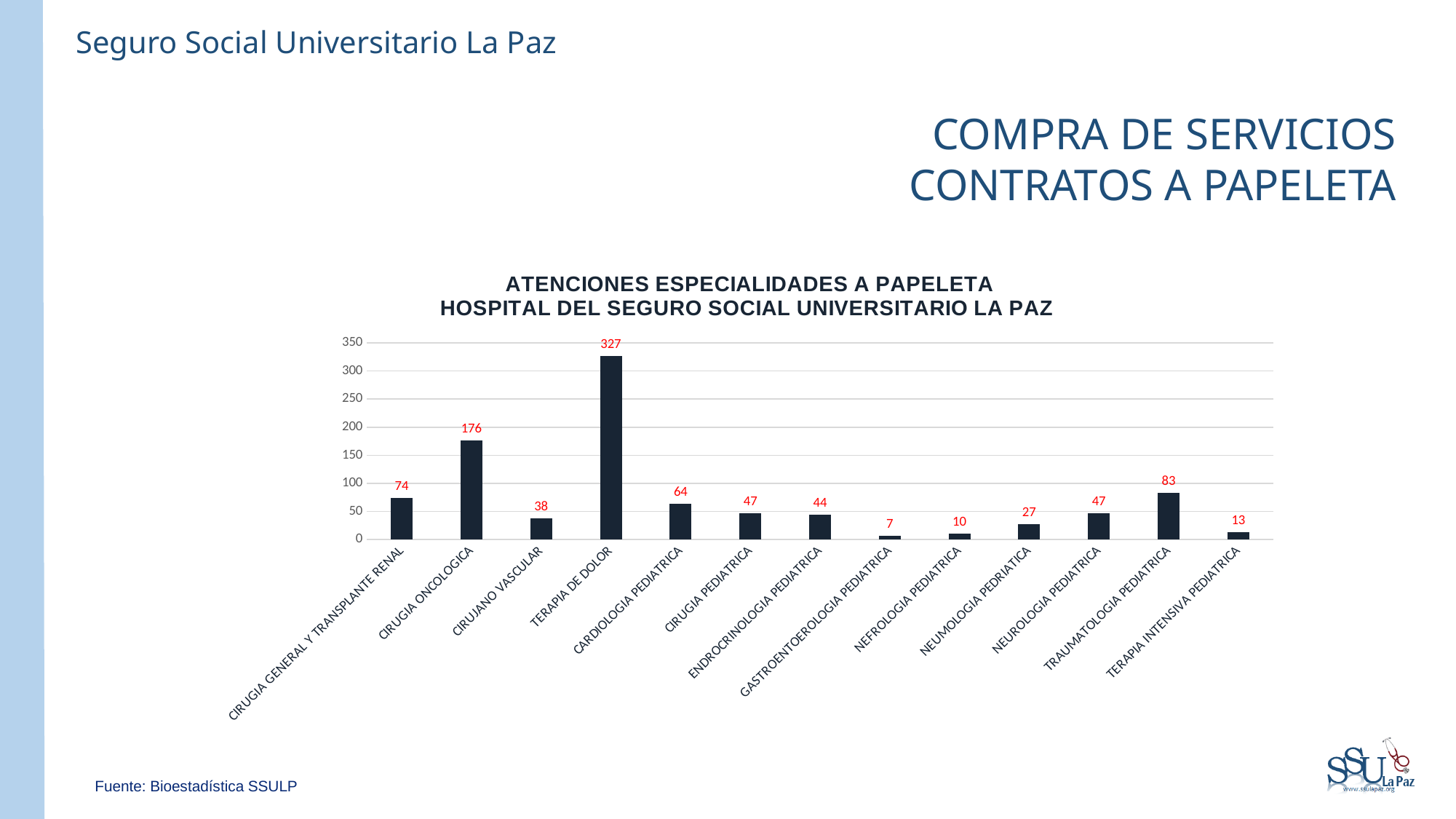
What is the value for TERAPIA DE DOLOR? 327 How many categories are shown on the x axis? 13 What kind of chart is shown on the slide? bar chart Which category has the lowest value? GASTROENTOEROLOGIA PEDIATRICA Which is larger, the value for CARDIOLOGIA PEDIATRICA or the value for CIRUJANO VASCULAR? CARDIOLOGIA PEDIATRICA Which category has the highest value? TERAPIA DE DOLOR What is the value for CIRUGIA ONCOLOGICA? 176 Is the value for CIRUGIA GENERAL Y TRANSPLANTE RENAL greater or less than 100? less What is the value for TRAUMATOLOGIA PEDIATRICA? 83 What is the value for NEFROLOGIA PEDIATRICA? 10 What is the difference between the values for TERAPIA DE DOLOR and CIRUGIA ONCOLOGICA? 151 What is the title of the chart? ATENCIONES ESPECIALIDADES A PAPELETA HOSPITAL DEL SEGURO SOCIAL UNIVERSITARIO LA PAZ